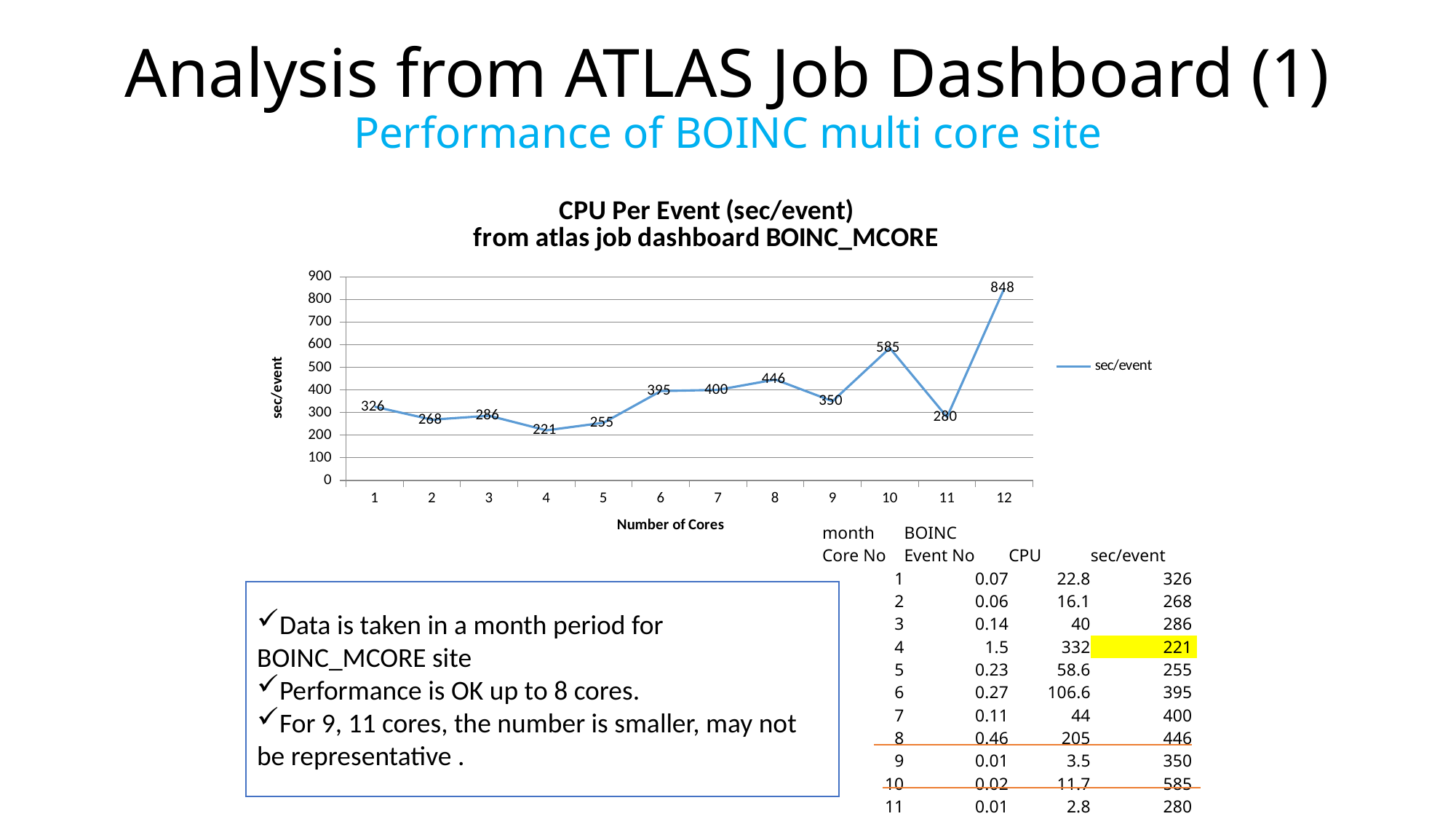
What is the sec/event value for 12 cores? 848 What kind of chart is shown? line chart How many core counts are plotted on the x axis? 12 Which number of cores has the lowest sec/event value? 4 Which number of cores has the highest sec/event value? 12 How many series does the legend list? 1 What is the sec/event value for 4 cores? 221 What is the difference in sec/event between 12 cores and 10 cores? 263 What is the label of the y axis? sec/event Which has a larger sec/event value, 9 cores or 11 cores? 9 cores Is the sec/event value for 8 cores greater or less than 400? greater What is the sec/event value for 10 cores? 585